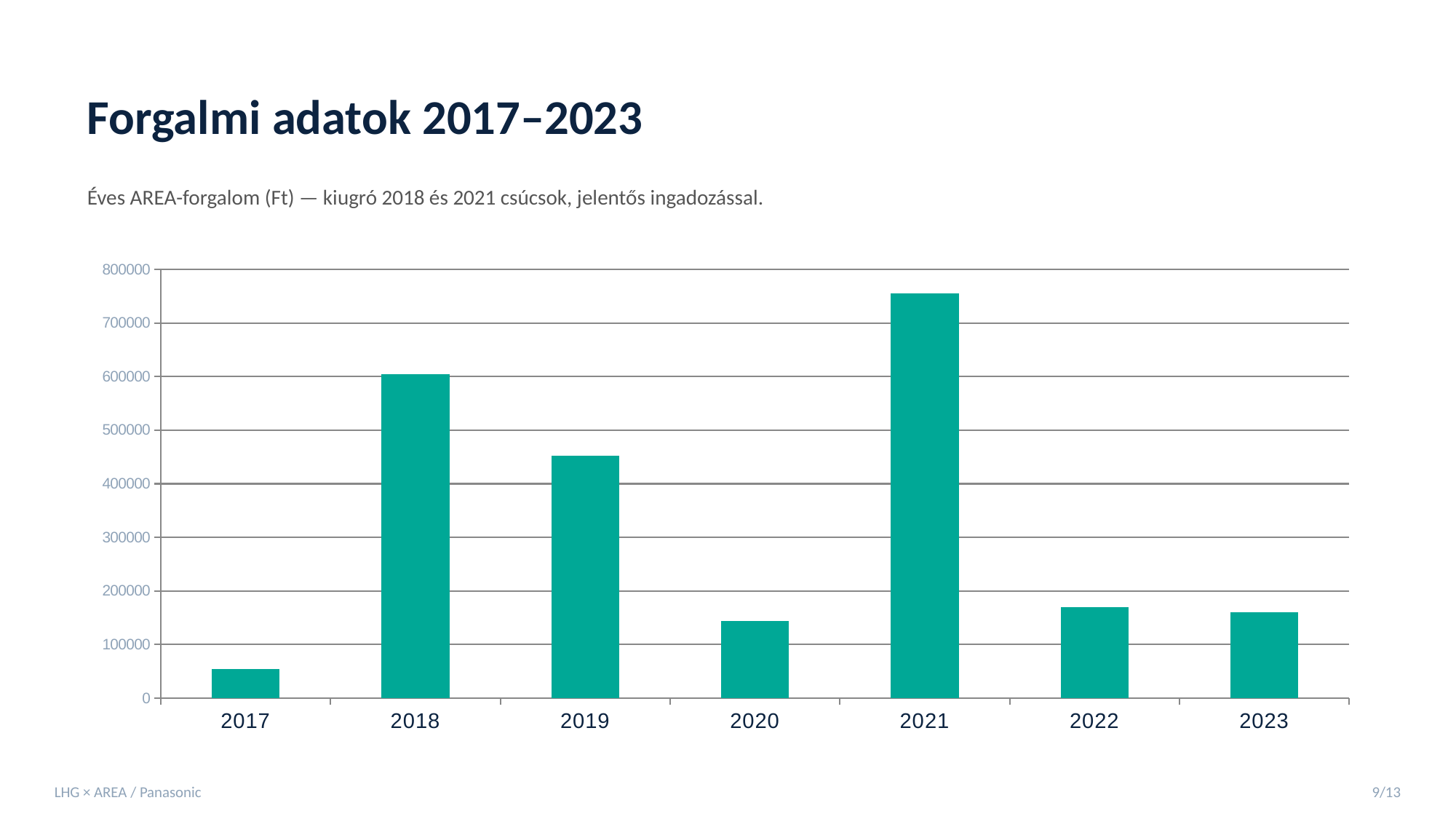
What is the title of the slide containing the chart? Forgalmi adatok 2017–2023 Is the value for 2017 greater or less than 100000? less Is the value for 2022 greater or less than 200000? less What kind of chart is shown on the slide? bar chart Which is larger, the value for 2020 or the value for 2021? 2021 Which year has the highest value in the chart? 2021 Which year has the lowest value in the chart? 2017 Which is larger, the value for 2018 or the value for 2019? 2018 Is the value for 2021 greater or less than 700000? greater How many years are shown on the x axis of the chart? 7